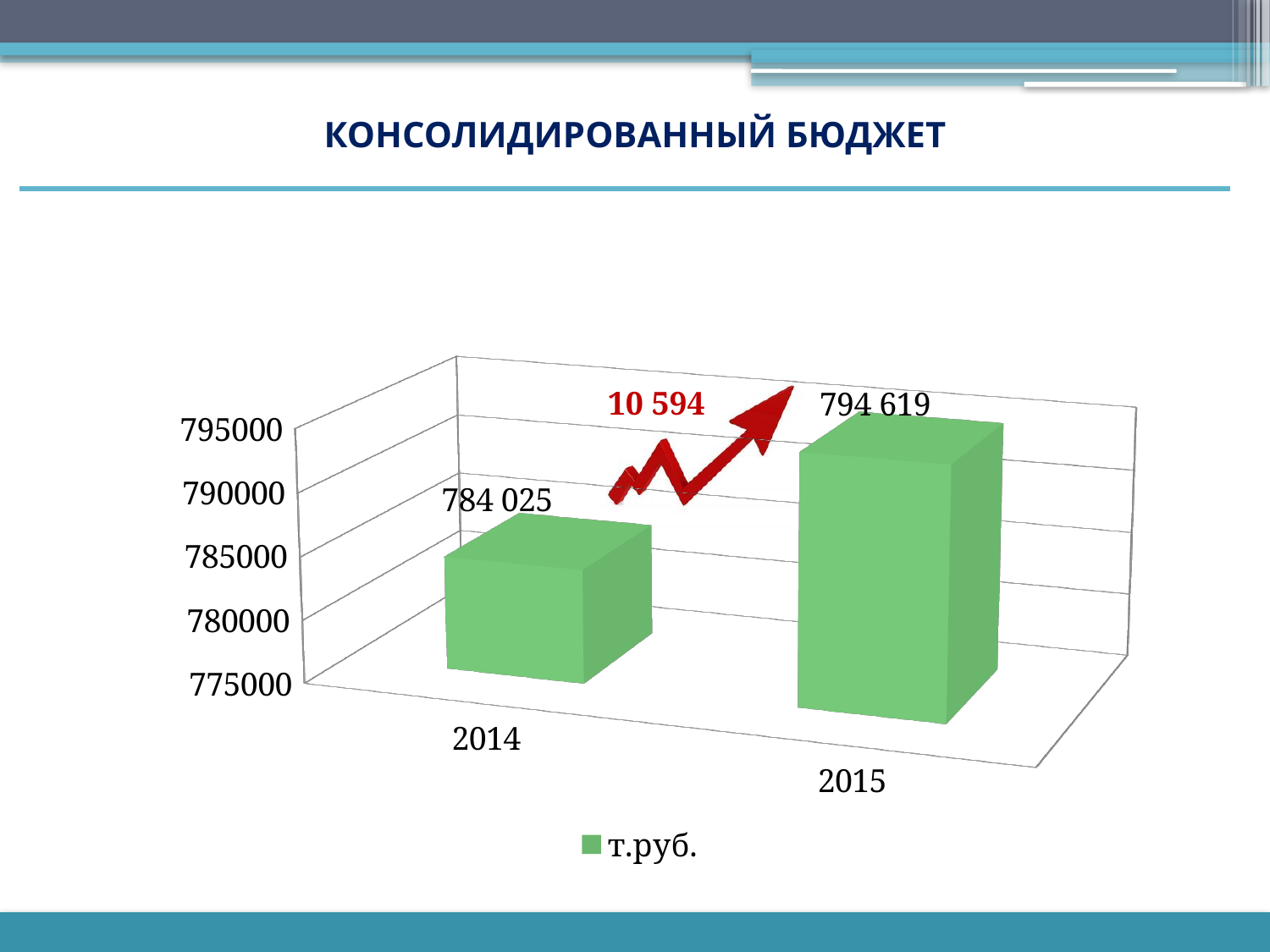
How many series does the legend list? 1 What is the difference between the 2015 and 2014 values? 10 594 Is the value for 2014 greater or less than 790000? less Do the values rise or fall from 2014 to 2015? Rise How many years are shown on the chart? 2 Is the value for 2015 larger than the value for 2014? Yes Which year has the lower value? 2014 What is the value for 2014? 784 025 Which year has the higher value? 2015 Is the value for 2015 greater or less than 790000? greater What kind of chart is shown? Bar chart What is the value for 2015? 794 619